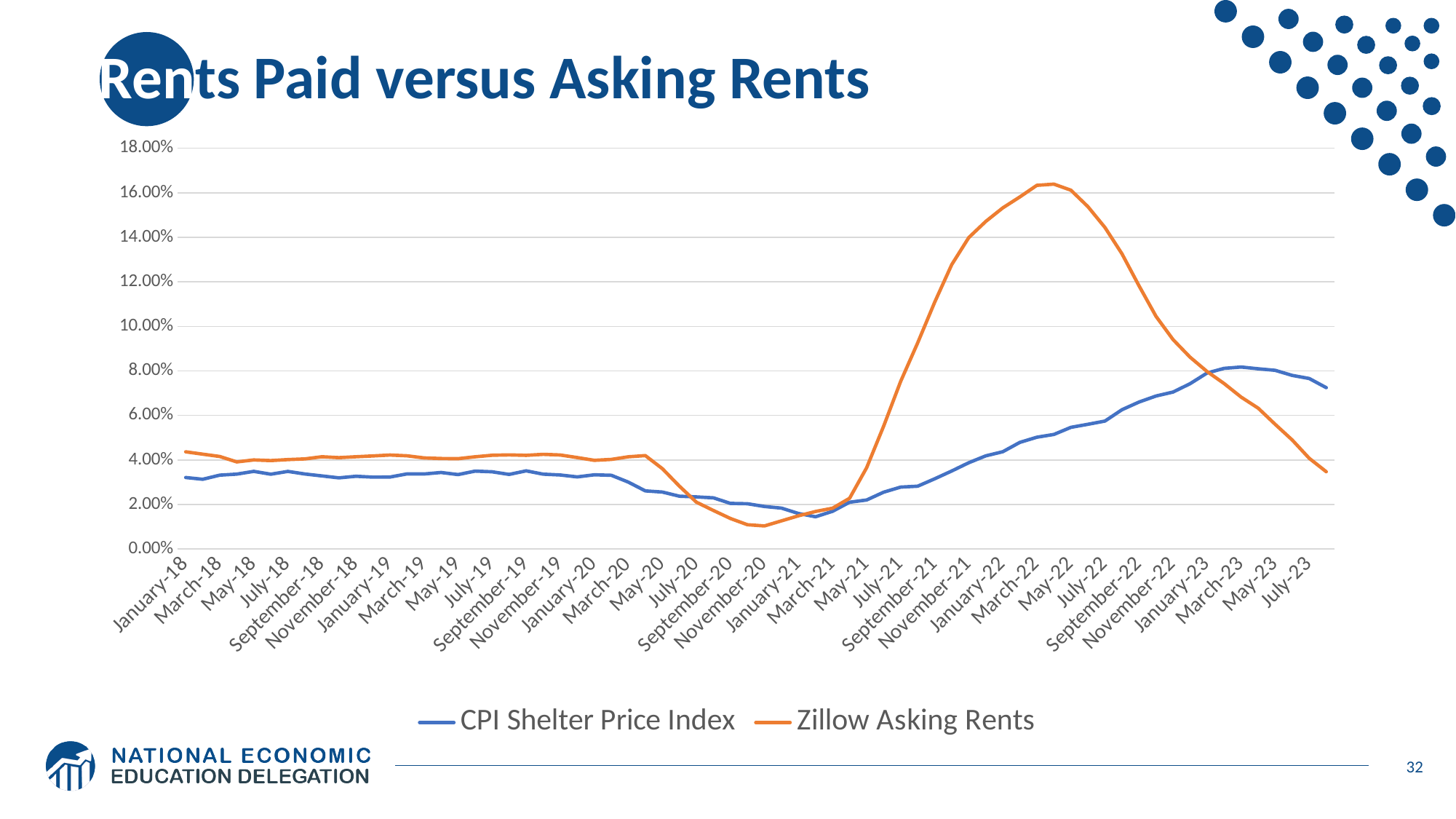
Is the value for Zillow Asking Rents in March-22 greater or less than 14.00%? greater Is the value for CPI Shelter Price Index in January-18 greater or less than 4.00%? less In March-22, which series has the higher value, CPI Shelter Price Index or Zillow Asking Rents? Zillow Asking Rents How many series does the legend list? 2 What kind of chart is shown on the slide? line chart Is the value for Zillow Asking Rents in November-20 greater or less than 2.00%? less Which series reaches the highest value anywhere on the chart? Zillow Asking Rents What is the title of the chart? Rents Paid versus Asking Rents In July-23, which series has the higher value, CPI Shelter Price Index or Zillow Asking Rents? CPI Shelter Price Index Does the Zillow Asking Rents line rise or fall between March-22 and July-23? fall What are the two series named in the legend? CPI Shelter Price Index and Zillow Asking Rents